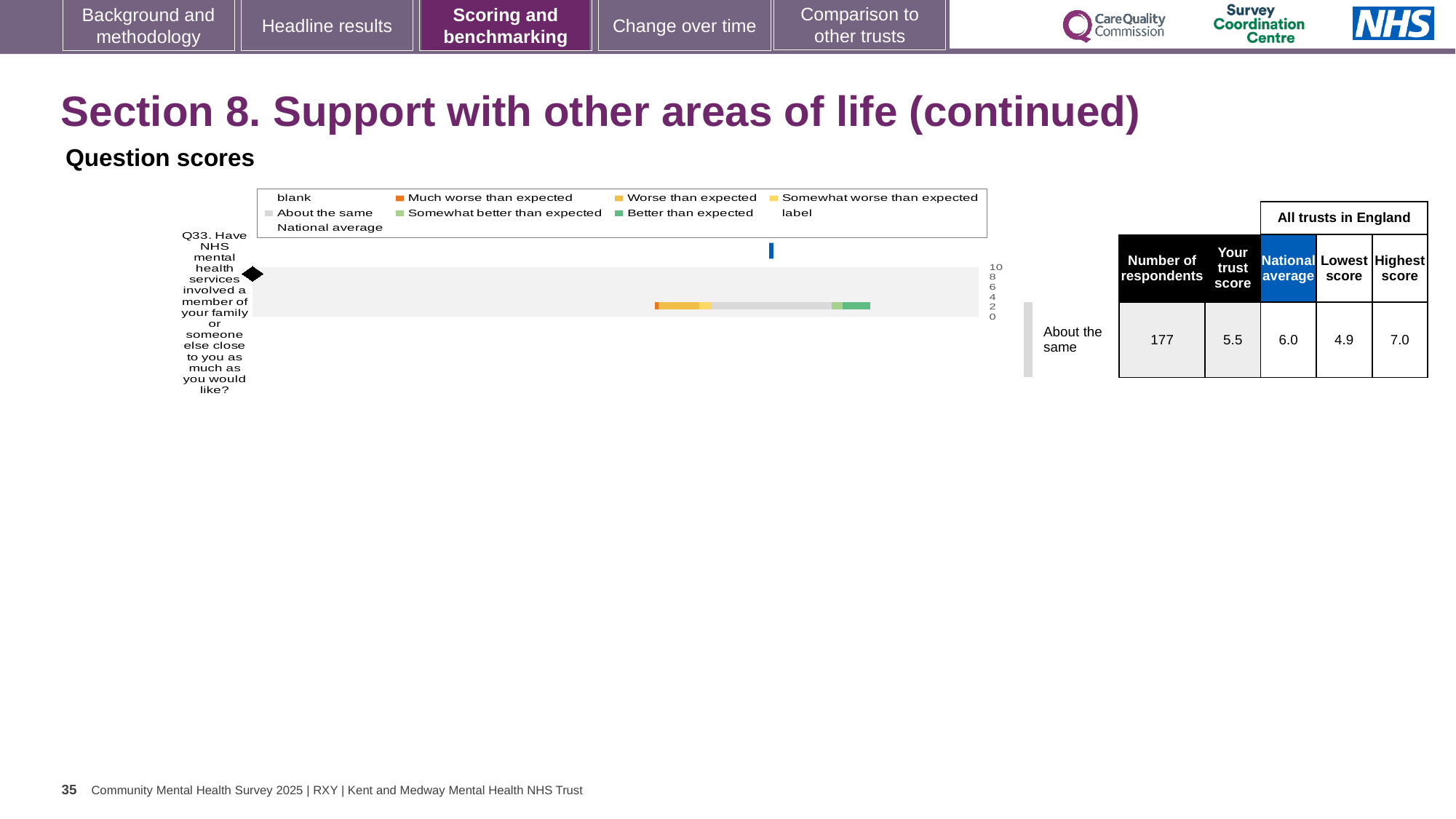
What is the difference between the national average and the trust's score for Q33? 0.5 What is the lowest score among all trusts in England for Q33? 4.9 What is the trust's score for Q33? 5.5 How is the trust's result for Q33 categorised relative to expectations? About the same Which is larger for Q33, the trust's score or the national average? national average How many survey questions are plotted in the chart? 1 What is the difference between the highest and lowest scores for Q33? 2.1 What kind of chart is shown on the slide? bar chart What is the national average score for Q33? 6.0 How many respondents answered Q33? 177 Which question is plotted in the chart? Q33. Have NHS mental health services involved a member of your family or someone else close to you as much as you would like? What is the highest score among all trusts in England for Q33? 7.0